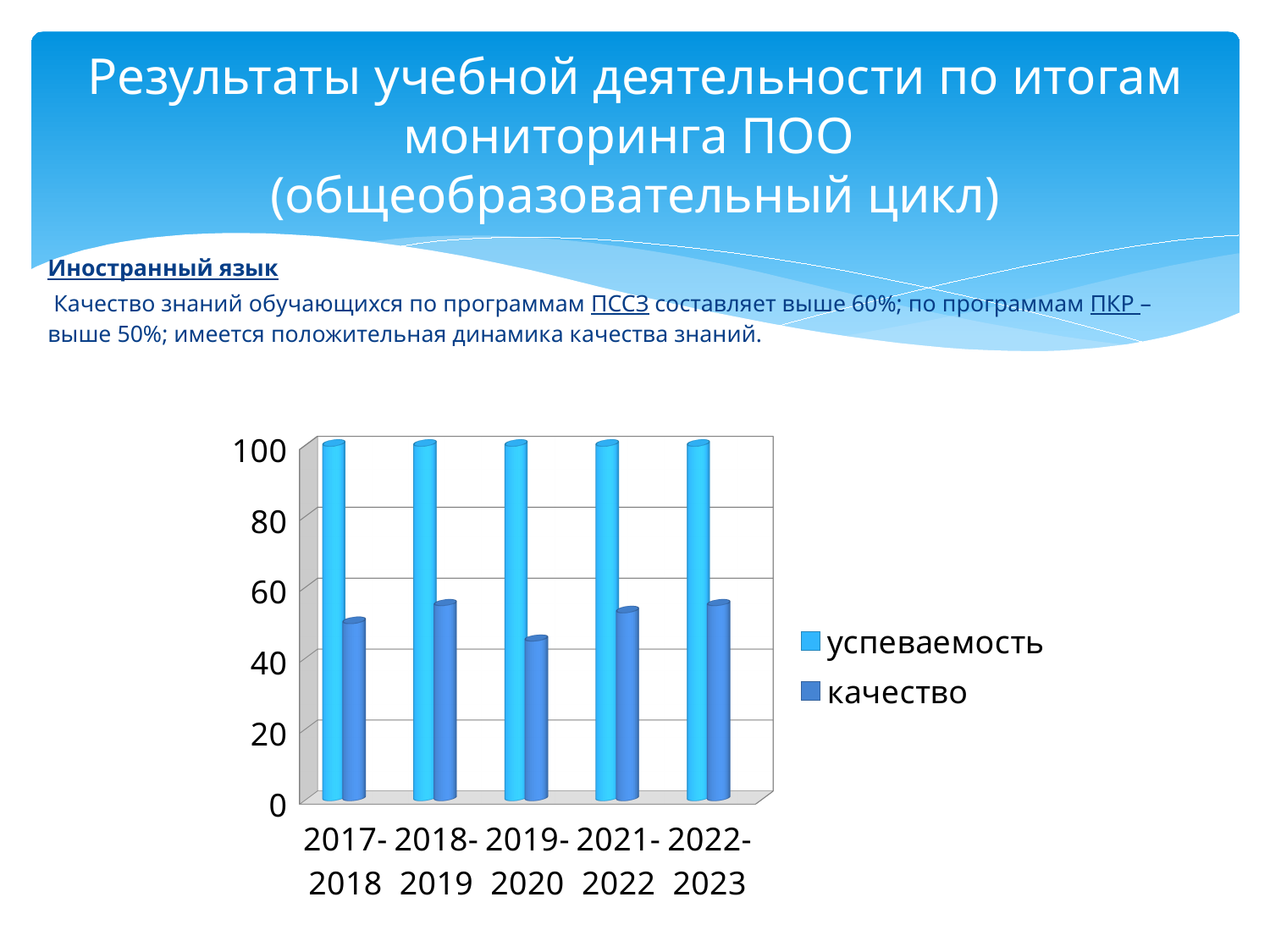
Is the качество value for 2019-2020 greater or less than 40? greater Is the качество value for 2019-2020 greater or less than 60? less How many series does the chart legend list? 2 Which is larger for 2021-2022: успеваемость or качество? успеваемость What is the value of успеваемость for 2022-2023? 100 In which academic year is the качество value lowest? 2019-2020 What are the two series named in the chart legend? успеваемость and качество What type of chart is shown on the slide? bar chart How many academic-year categories are shown on the x axis of the chart? 5 Is the качество value for 2018-2019 greater or less than 60? less Which is larger: the качество value for 2018-2019 or for 2019-2020? 2018-2019 What is the value of успеваемость for 2017-2018? 100